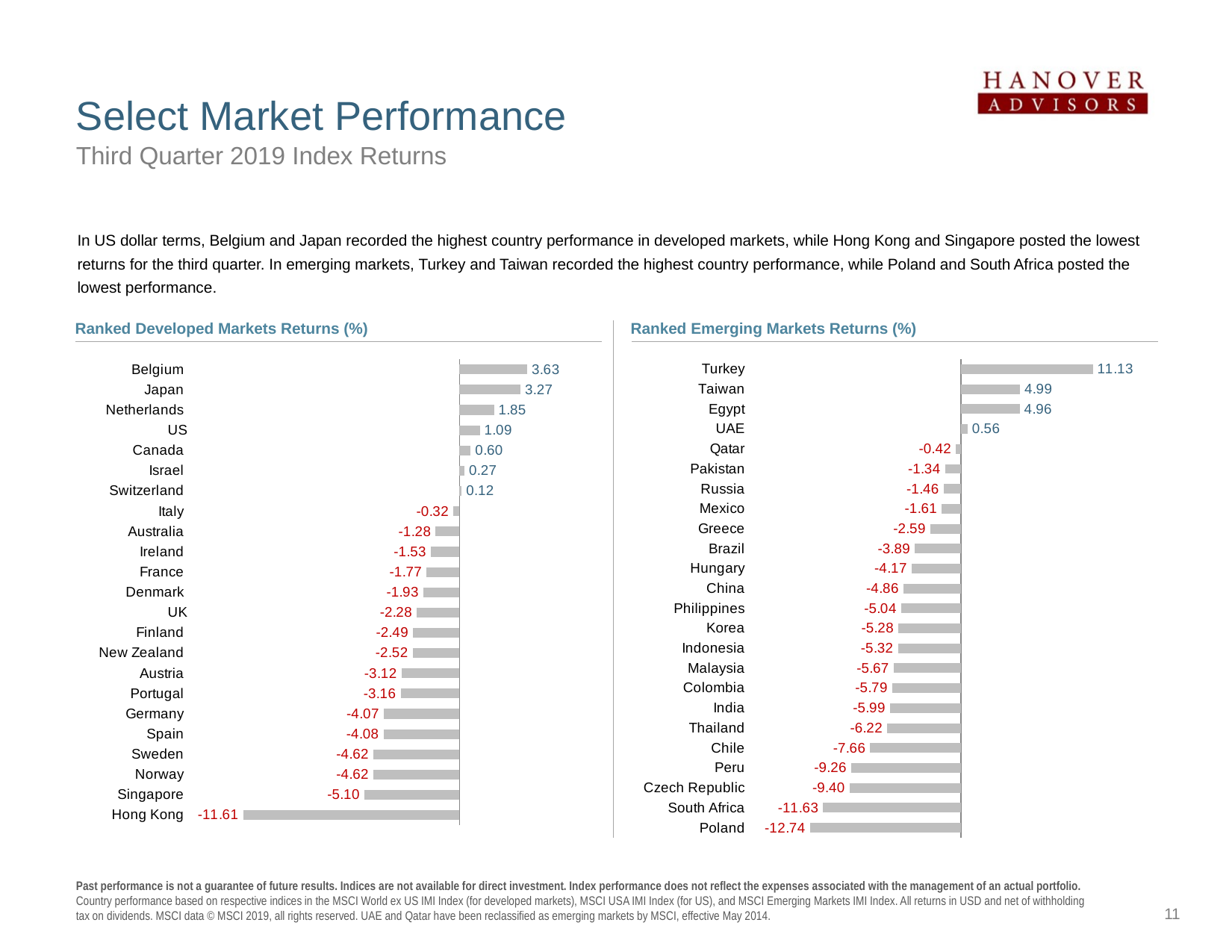
In the Ranked Emerging Markets Returns (%) chart, what is the value for South Africa? -11.63 What type of chart is the Ranked Emerging Markets Returns (%) chart? Bar chart In the Ranked Developed Markets Returns (%) chart, what is the difference between the values for Belgium and Japan? 0.36 In the Ranked Emerging Markets Returns (%) chart, what is the difference between the values for Turkey and Taiwan? 6.14 In the Ranked Developed Markets Returns (%) chart, which country has the highest return? Belgium In the Ranked Emerging Markets Returns (%) chart, which country has the lowest return? Poland How many countries are shown in the Ranked Emerging Markets Returns (%) chart? 24 How many countries are shown in the Ranked Developed Markets Returns (%) chart? 23 In the Ranked Developed Markets Returns (%) chart, what is the value for Belgium? 3.63 In the Ranked Emerging Markets Returns (%) chart, what is the value for Turkey? 11.13 In the Ranked Developed Markets Returns (%) chart, what is the value for Hong Kong? -11.61 Which is larger: the value for Japan in the Ranked Developed Markets Returns (%) chart or the value for Taiwan in the Ranked Emerging Markets Returns (%) chart? Taiwan